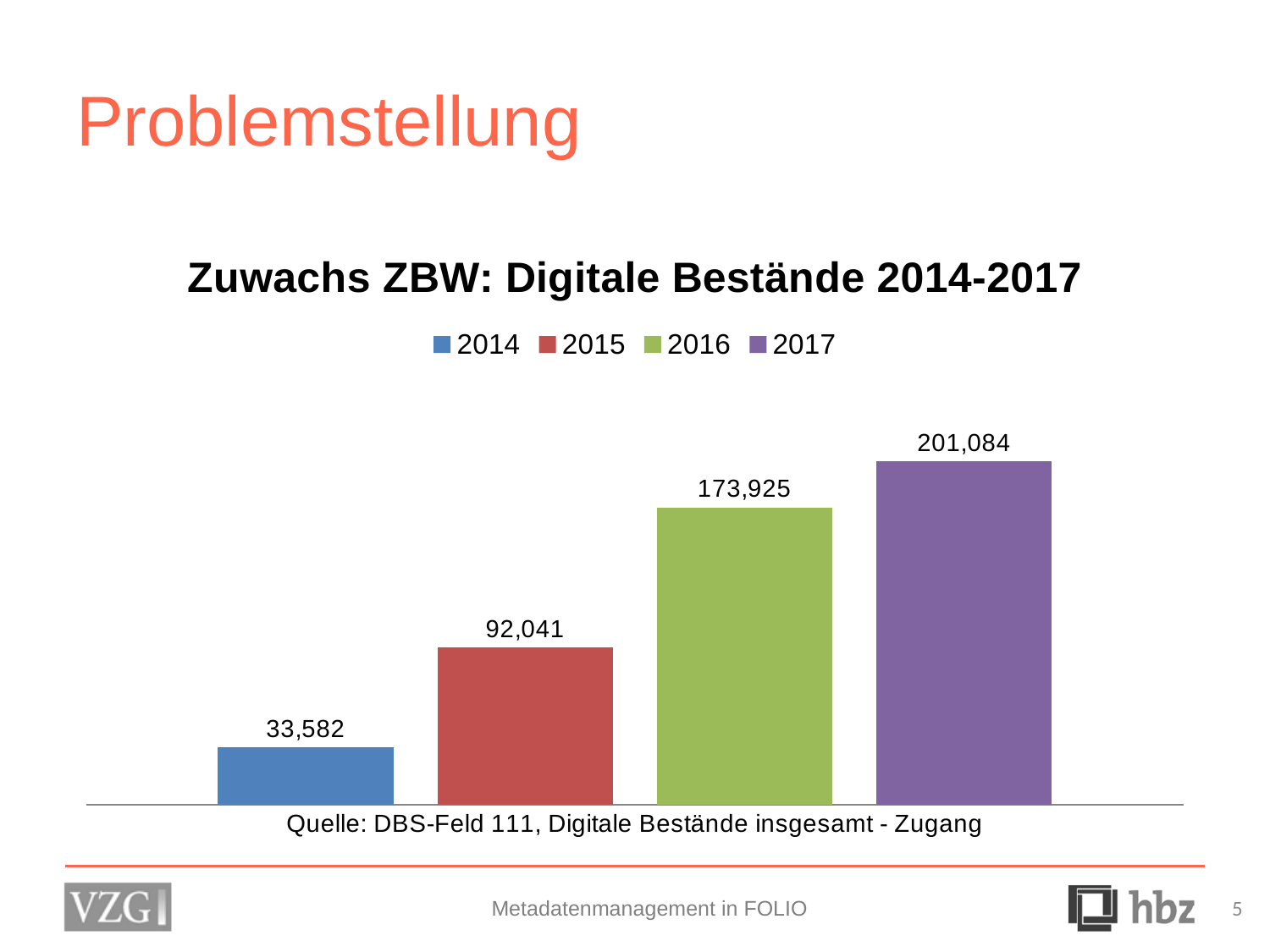
What is the difference between the values for 2015 and 2014? 58,459 What is the value shown for 2015? 92,041 How many bars are plotted in the chart? 4 What is the value shown for 2017? 201,084 Which year has the lowest value? 2014 What is the difference between the values for 2017 and 2016? 27,159 Do the values rise or fall from 2014 to 2017? rise What is the value shown for 2016? 173,925 Which is larger, the value for 2015 or the value for 2016? 2016 Which year has the highest value? 2017 What is the value shown for 2014? 33,582 How many series does the legend list? 4